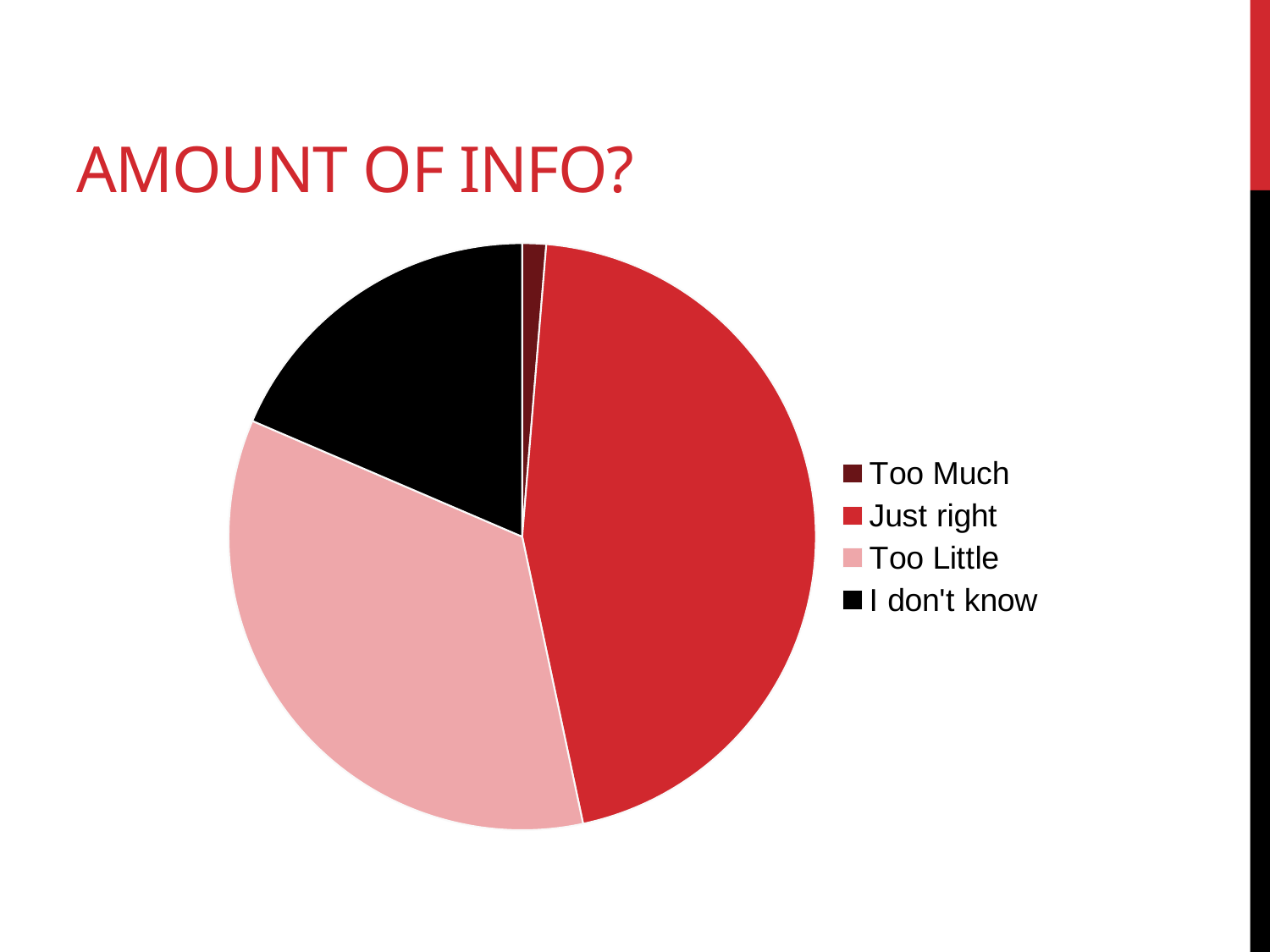
Which category has the smallest slice of the pie chart? Too Much Which category is shown in black in the pie chart? I don't know How many categories (slices) does the pie chart have? 4 Which slice is larger: I don't know or Too Much? I don't know Which category has the largest slice of the pie chart? Just right How many entries are listed in the legend of the pie chart? 4 What kind of chart is shown on the slide? pie chart What is the title of the slide with the pie chart? AMOUNT OF INFO? Which slice is larger: Just right or Too Little? Just right Which slice is larger: Too Little or I don't know? Too Little